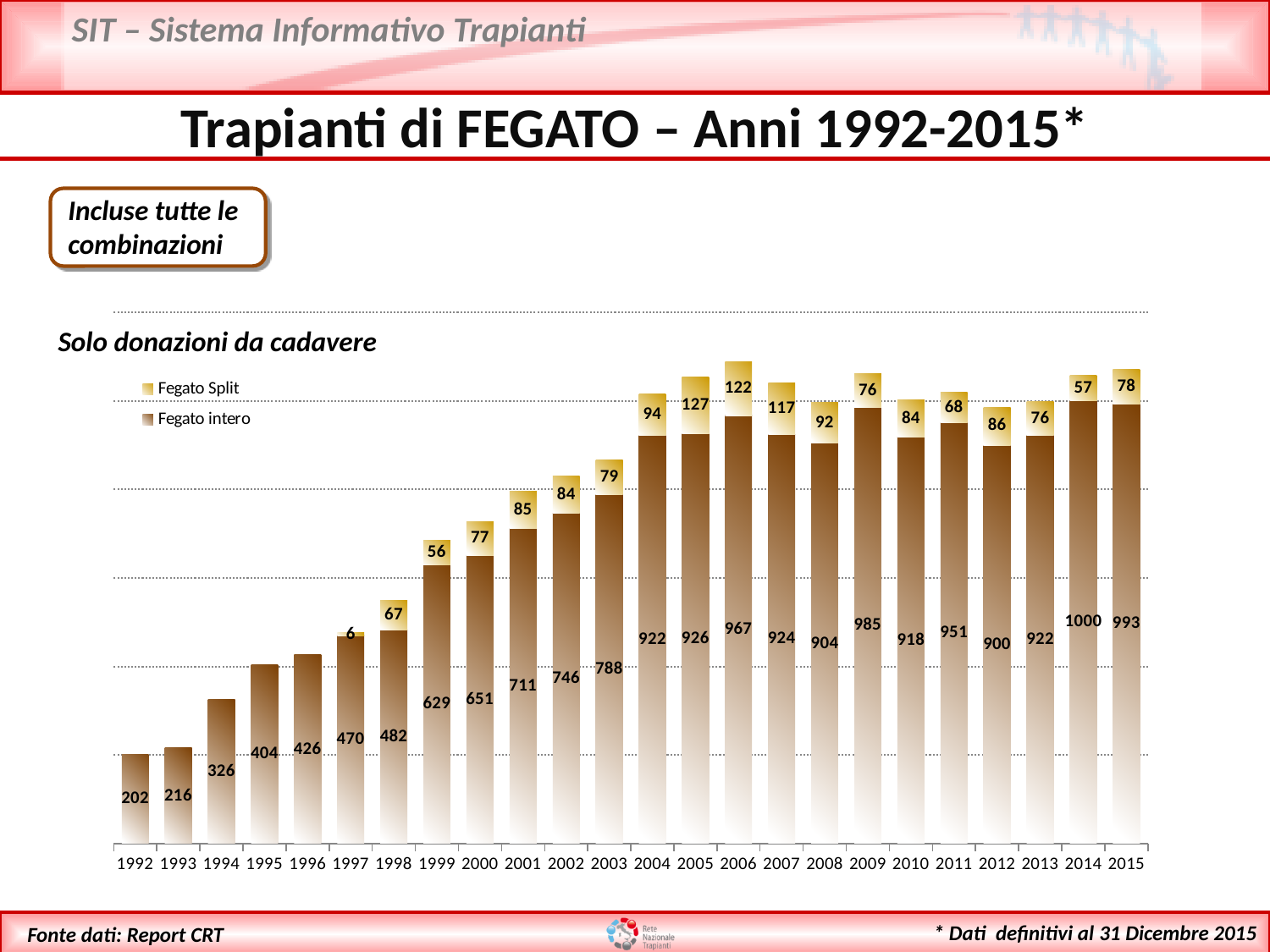
What is the difference between the Fegato intero values for 2015 and 2014? 7 What kind of chart is shown on the slide? Stacked bar chart Which year has the highest value for Fegato Split? 2005 How many years are shown on the x axis? 24 What is the value of Fegato intero for 2014? 1000 What is the value of Fegato Split for 2005? 127 What is the value of Fegato intero for 1992? 202 What are the two series named in the legend? Fegato Split and Fegato intero Which is larger, the Fegato intero value for 2006 or for 2009? 2009 How many series does the legend list? 2 Which year has the lowest value for Fegato intero? 1992 What is the total of the stacked bar for 2015 (Fegato intero plus Fegato Split)? 1071